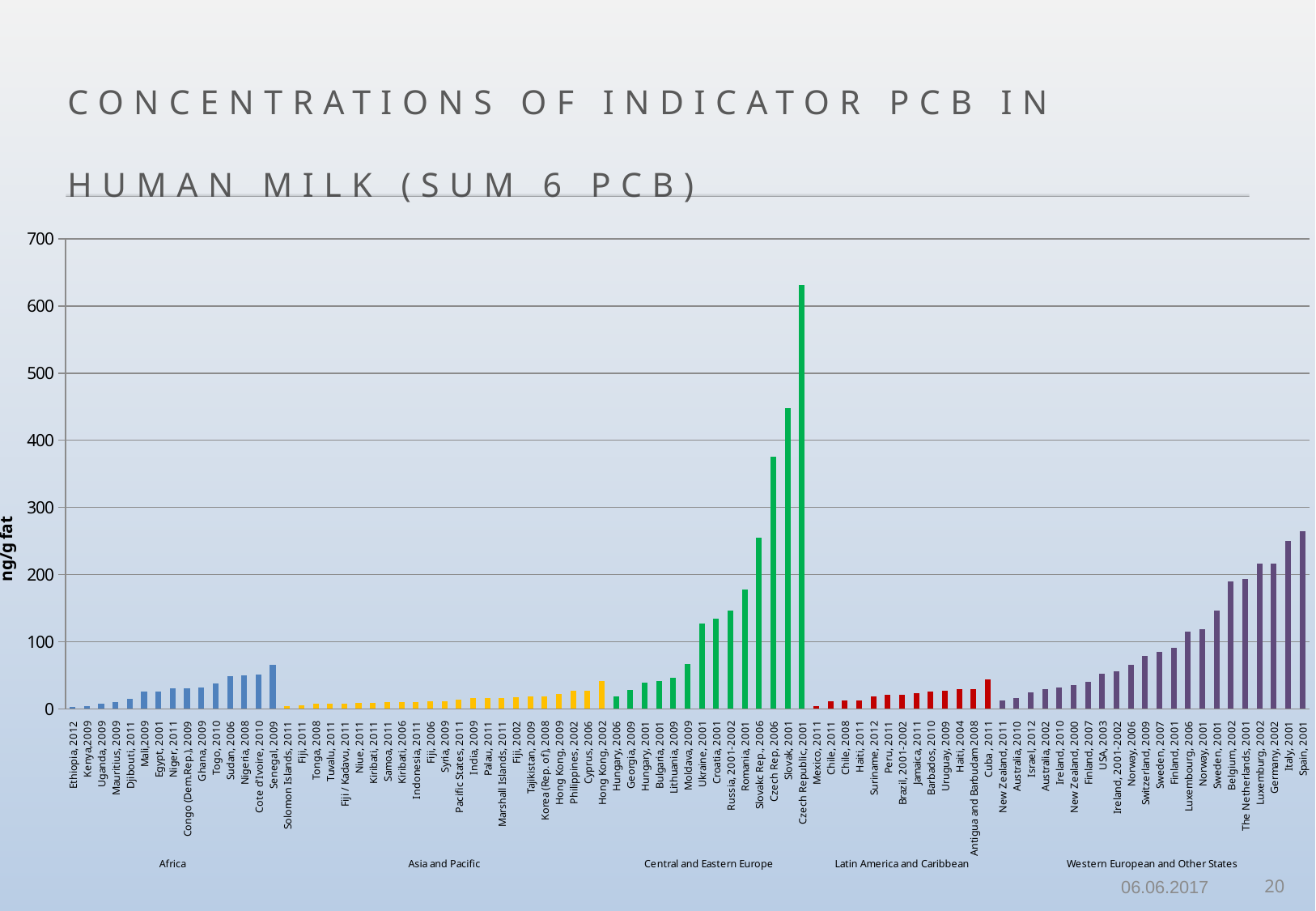
Is the value for Slovak, 2001 greater or less than 400? greater Is the value for Czech Republic, 2001 greater or less than 600? greater What is the label on the y axis of the chart? ng/g fat Which country and year has the highest concentration of indicator PCB in human milk? Czech Republic, 2001 Is the value for Spain, 2001 greater or less than 200? greater What kind of chart is shown on the slide? bar chart Which has the larger value, Czech Republic, 2001 or Slovak, 2001? Czech Republic, 2001 Within the Western European and Other States group, do the values rise or fall from left to right? rise Which has the larger value, Senegal, 2009 or Cuba, 2011? Senegal, 2009 How many regional groups are the countries divided into along the x axis? 5